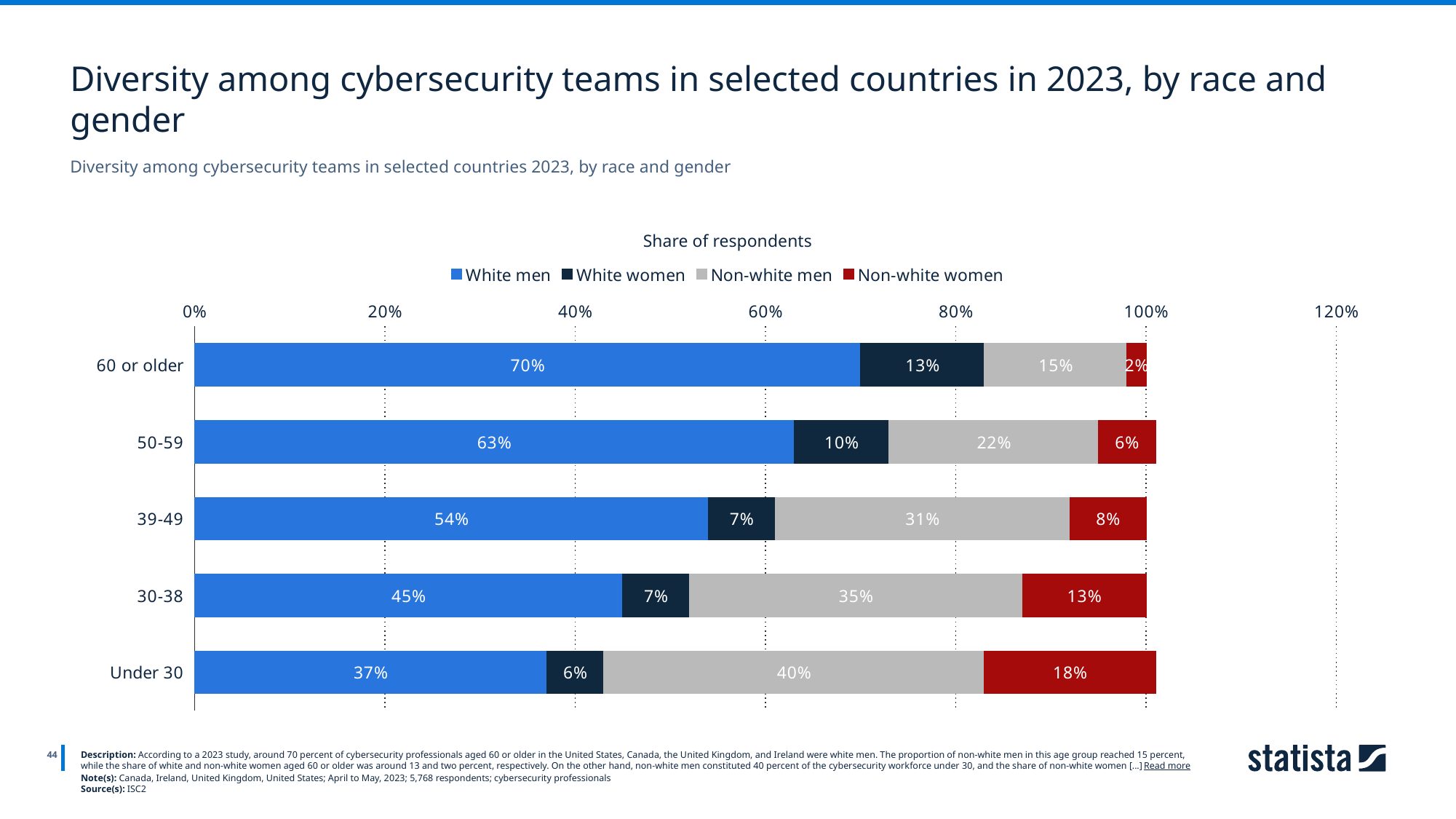
Which age group has the lowest share of non-white women? 60 or older Which age group has the highest share of white men? 60 or older What kind of chart is shown on the slide? Stacked bar chart What share of respondents aged 60 or older are white men? 70% Which colour represents non-white women in the chart? Red How many age groups are shown in the chart? 5 Which is larger: the share of non-white men aged 30-38 or the share of non-white men aged 50-59? 30-38 What share of respondents aged 39-49 are non-white men? 31% How many series does the legend list? 4 What is the difference between the share of white men in the 60 or older group and the under 30 group? 33% What share of respondents aged 50-59 are white women? 10% What share of respondents under 30 are non-white women? 18%